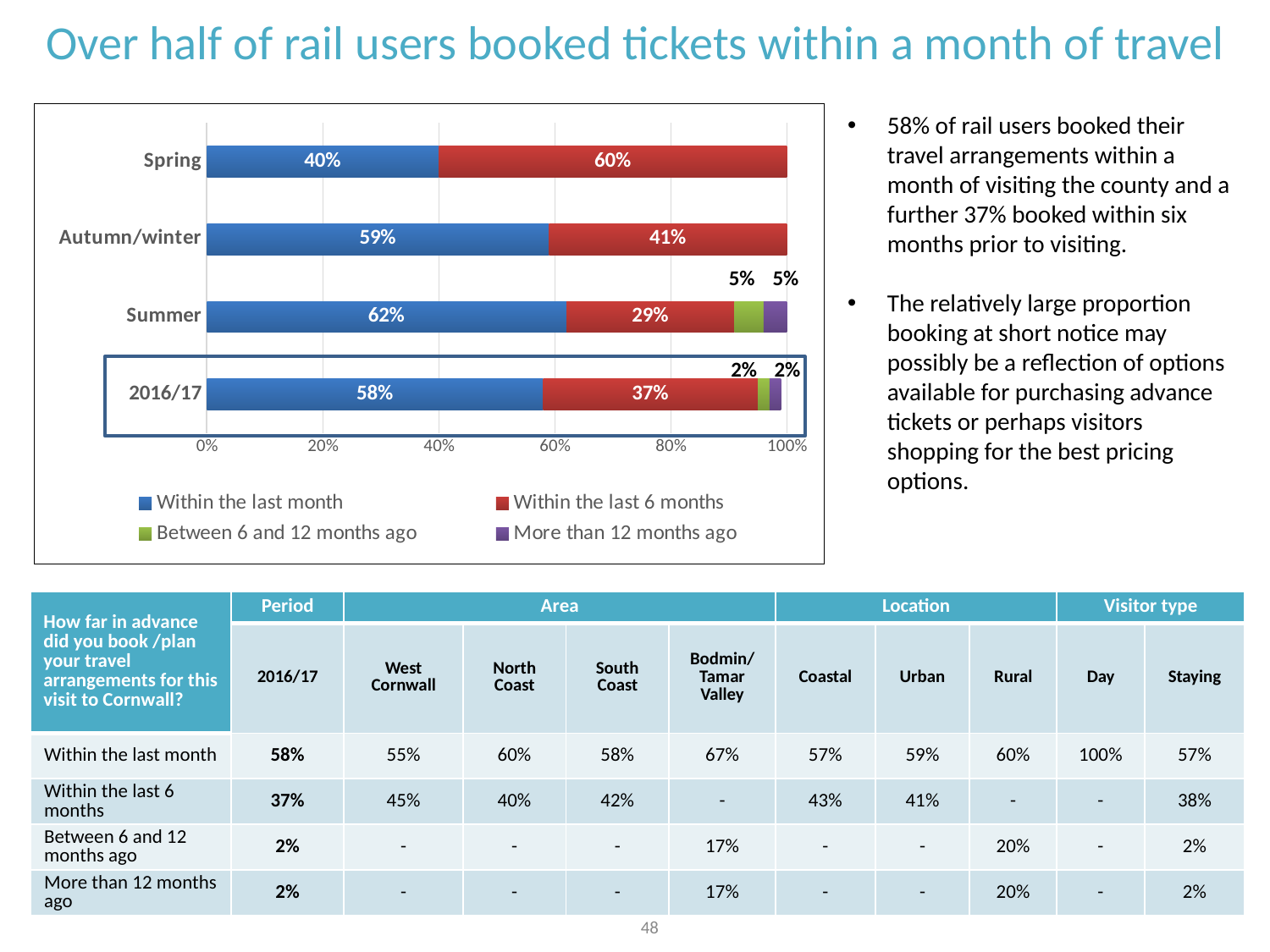
How many series does the chart legend list? 4 Which category has the lowest value for 'Within the last month'? Spring What is the value for 'Between 6 and 12 months ago' for 2016/17? 2% What kind of chart is shown on the slide? Stacked bar chart What is the difference between the 'Within the last month' values for Summer and Spring? 22% Which is larger: the 'Within the last 6 months' value for Spring or for Summer? Spring What is the value for 'Within the last month' for Summer? 62% Which category has the highest value for 'Within the last month'? Summer How many categories are shown on the y axis of the chart? 4 What is the value for 'Within the last 6 months' for Autumn/winter? 41% What percentage of rail users in Spring booked within the last month? 40% What is the total of the 'Within the last month' and 'Within the last 6 months' segments for 2016/17? 95%